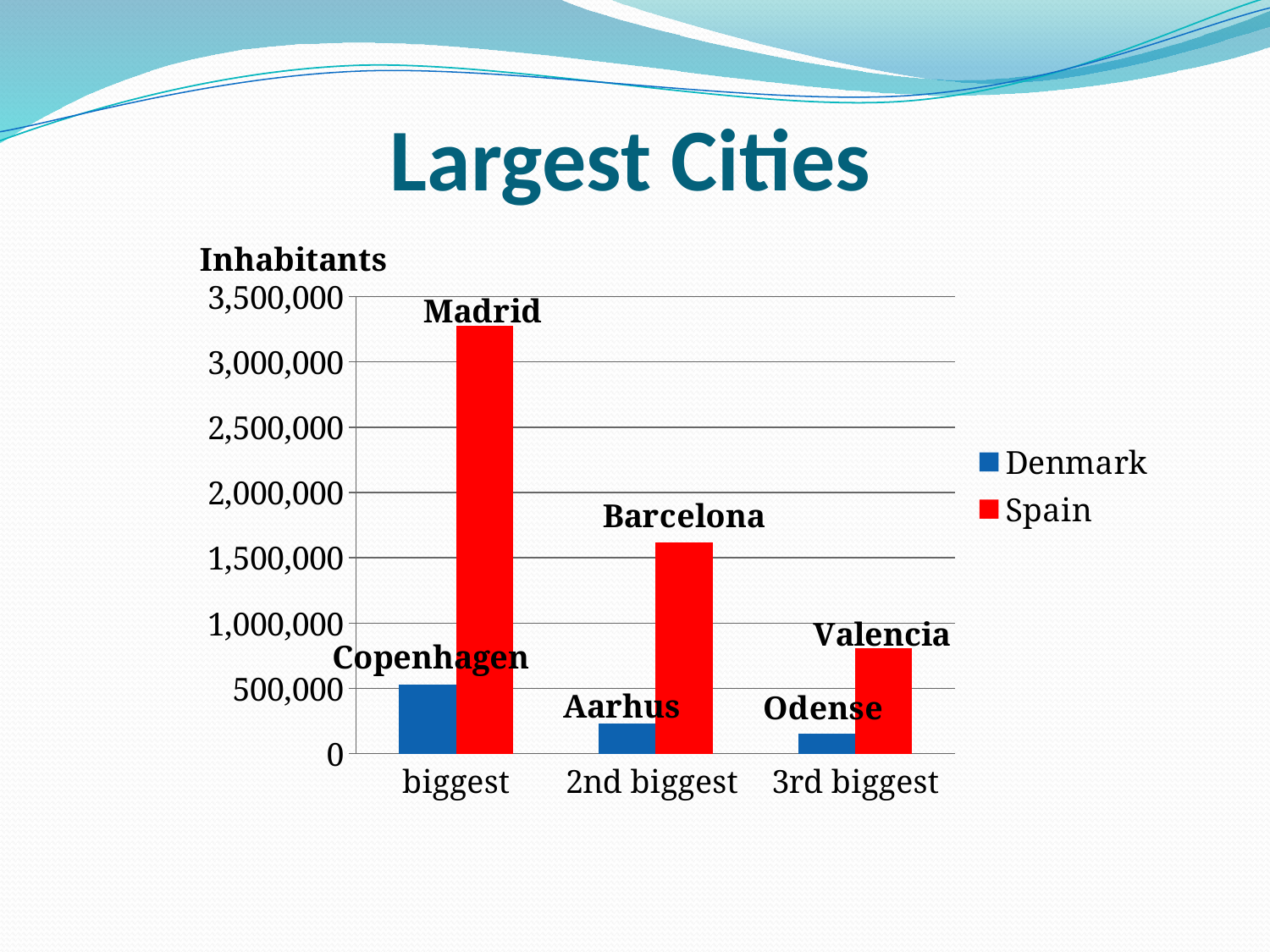
How many categories are shown on the x axis? 3 Is the value for Barcelona greater or less than 1,500,000? greater What is the title of the slide containing the chart? Largest Cities Which category has the lowest value for the Denmark series? 3rd biggest Which category has the highest value for the Spain series? biggest How many series does the legend list? 2 Is the value for Aarhus greater or less than 500,000? less Is the value for Valencia greater or less than 1,000,000? less Which is larger, the value for Madrid or the value for Copenhagen? Madrid What kind of chart is shown on the slide? bar chart Do the values for the Spain series rise or fall from 'biggest' to '3rd biggest'? fall